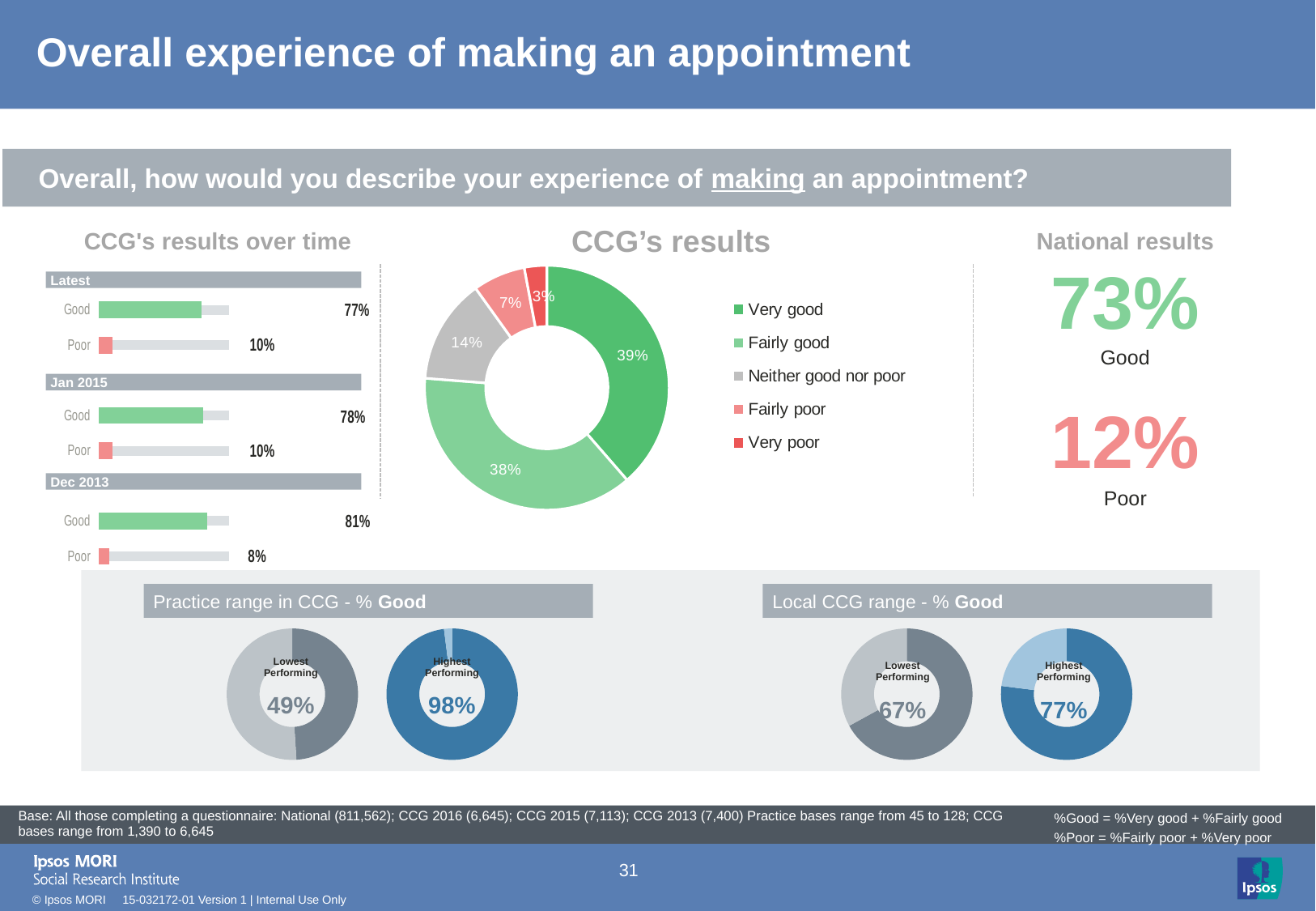
In the "CCG's results over time" chart, what is the Good percentage for Dec 2013? 81% In the "CCG's results over time" chart, what is the Poor percentage for the Latest period? 10% In the "CCG's results" donut chart, which category has the largest share? Very good In the "CCG's results" donut chart, which category has the smallest share? Very poor In the "CCG's results" donut chart, how many categories does the legend list? 5 In the "Local CCG range - % Good" section, what is the Lowest Performing value? 67% In the "CCG's results" donut chart, what is the difference between the Fairly poor and Very poor percentages? 4% In the "CCG's results over time" chart, what is the difference between the Good percentage for Dec 2013 and the Latest period? 4% In the "CCG's results" donut chart, what percentage is shown for Fairly good? 38% In the "CCG's results over time" chart, which period has the highest Good percentage? Dec 2013 In the "CCG's results" donut chart, what percentage is shown for Neither good nor poor? 14% In the "Practice range in CCG - % Good" section, what is the Highest Performing value? 98%